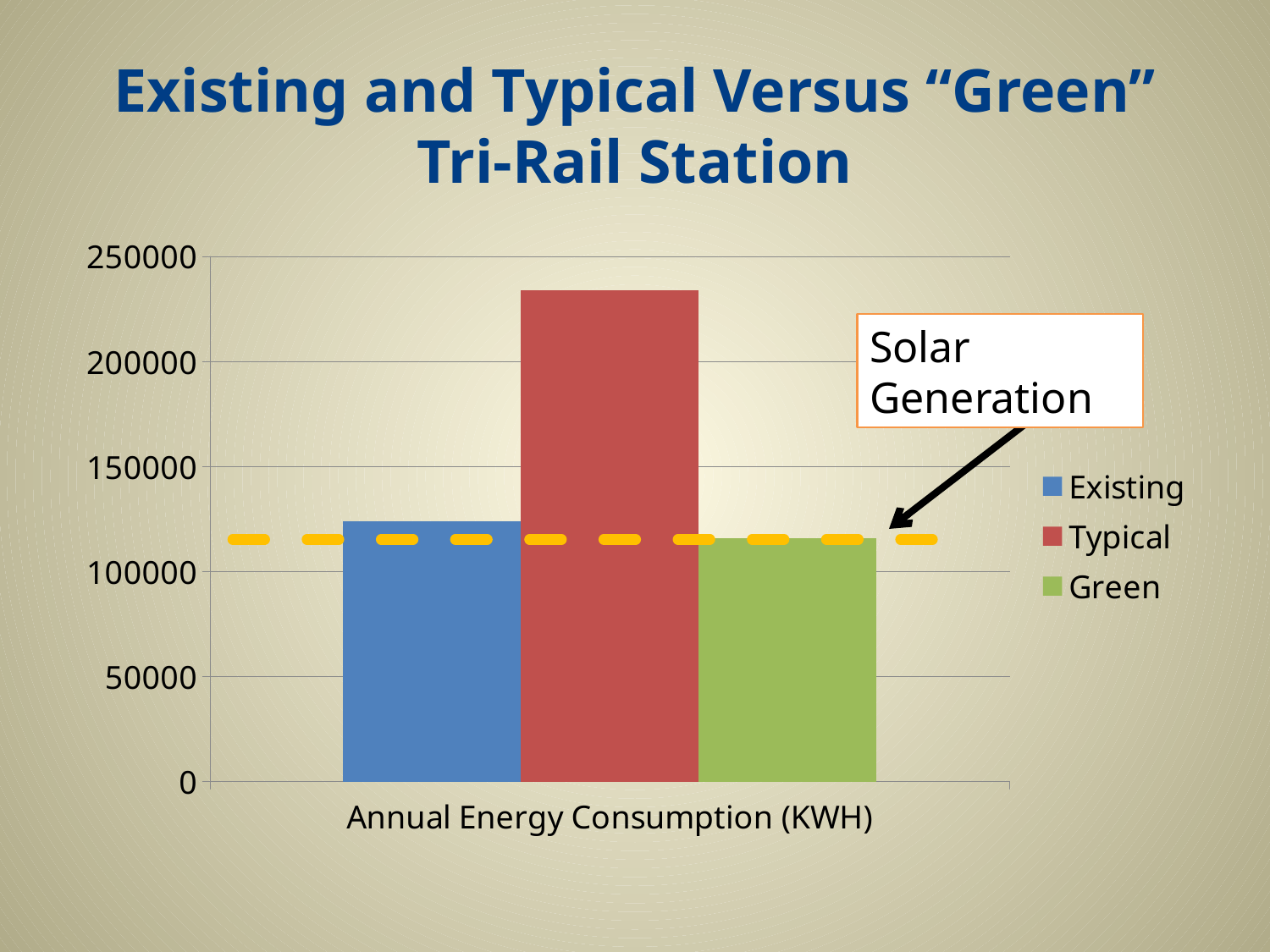
Is the value for Typical greater or less than 200000? greater Is the value for Typical greater or less than 250000? less Which is larger, the value for Typical or the value for Green? Typical Is the value for Existing greater or less than 150000? less Which is larger, the value for Existing or the value for Typical? Typical How many series does the legend list? 3 What kind of chart is shown on the slide? bar chart What does the dashed yellow line on the chart represent, according to the callout? Solar Generation What is the label shown below the x axis of the chart? Annual Energy Consumption (KWH) Which series has the lowest annual energy consumption? Green Which series has the highest annual energy consumption? Typical